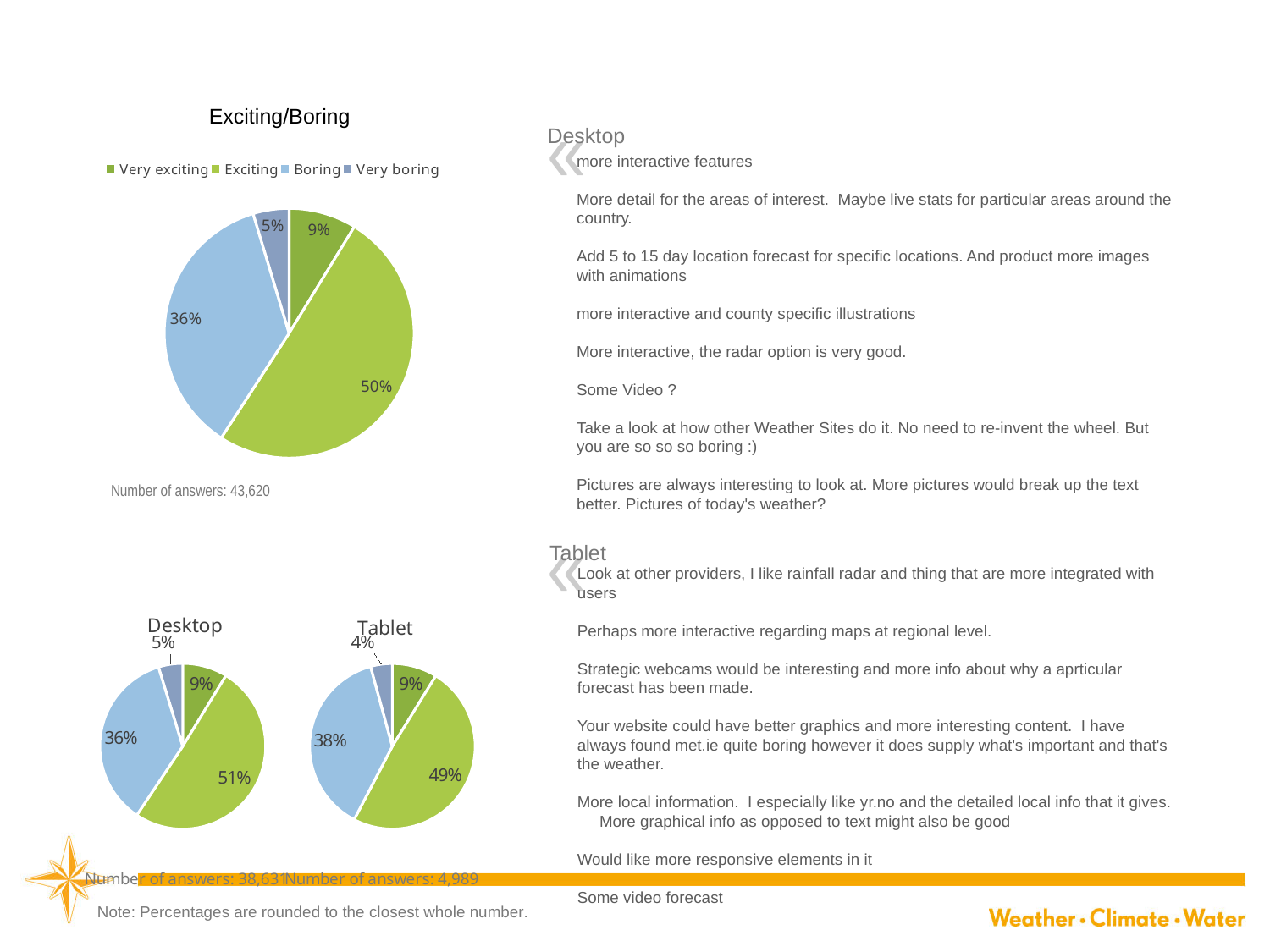
In the Exciting/Boring pie chart, what is the difference in percentage points between 'Exciting' and 'Boring'? 14 In the Tablet pie chart, what share of answers is 'Exciting'? 49% How many series does the legend of the Exciting/Boring chart list? 4 In the Desktop pie chart, what share of answers is 'Boring'? 36% In the Exciting/Boring pie chart, what share of answers is 'Very boring'? 5% How many pie charts are shown on the slide? 3 In the Tablet pie chart, what share of answers is 'Very boring'? 4% In the Exciting/Boring pie chart, which category has the smallest share? Very boring What kind of chart is the Exciting/Boring chart? Pie chart In the Exciting/Boring pie chart, what share of answers is 'Exciting'? 50% In the Exciting/Boring pie chart, which category has the largest share? Exciting Which is larger: the 'Boring' share in the Desktop pie chart or the 'Boring' share in the Tablet pie chart? Tablet